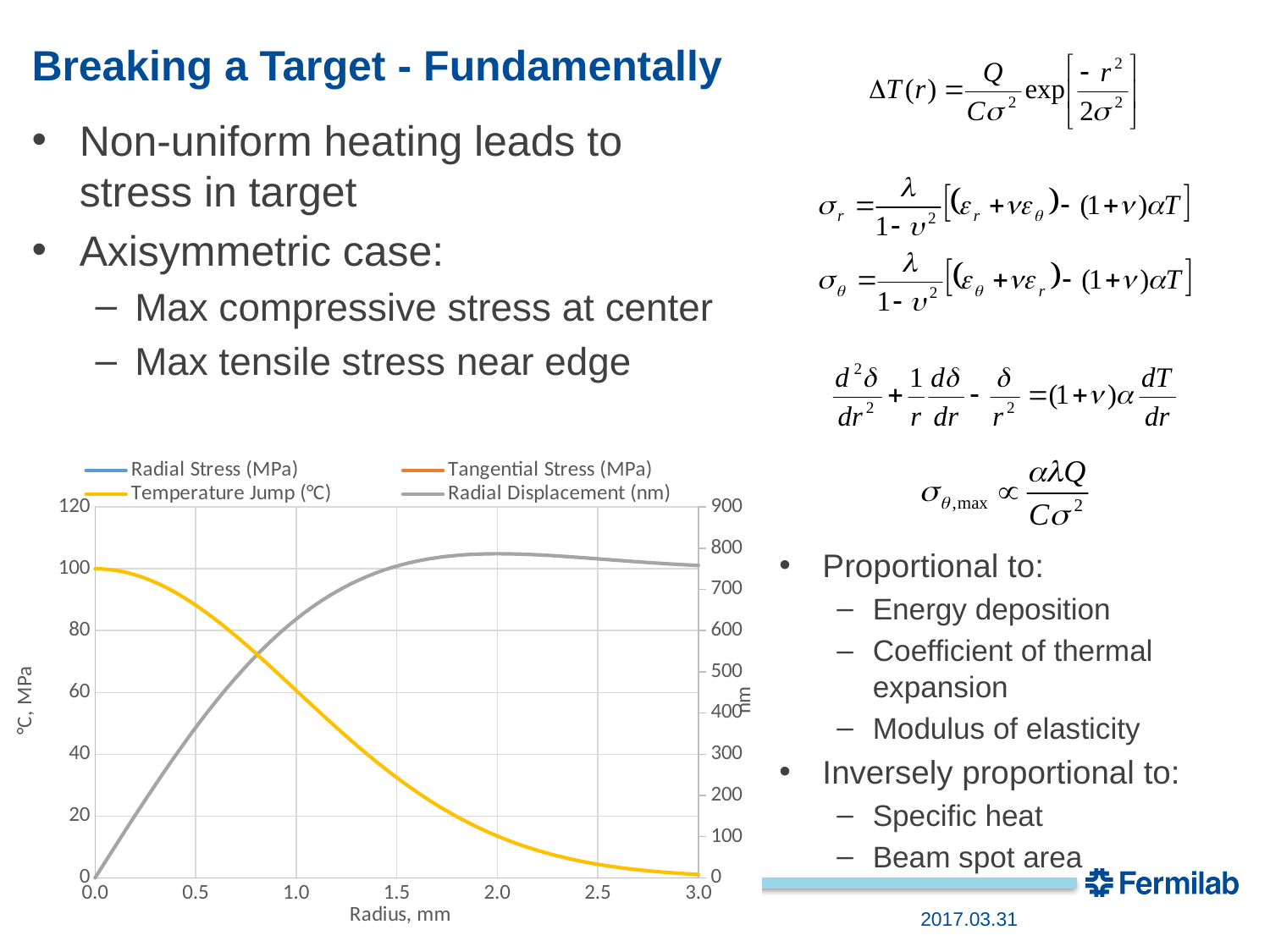
Is the Temperature Jump (°C) at a radius of 2.0 mm greater or less than 20? less Is the Temperature Jump (°C) at a radius of 0.5 mm greater or less than 80? greater What is the label of the x axis of the chart? Radius, mm Does the Temperature Jump (°C) rise or fall as the radius increases from 0.0 to 3.0 mm? fall Does the Radial Displacement (nm) rise or fall as the radius increases from 0.0 to 2.0 mm? rise What is the Temperature Jump (°C) at a radius of 0.0 mm? 100 Is the Temperature Jump (°C) at a radius of 1.0 mm greater or less than 80? less At which radius is the Temperature Jump (°C) highest? 0.0 What kind of chart is shown on the slide? line chart How many series does the chart legend list? 4 What is the Radial Displacement (nm) at a radius of 0.0 mm? 0